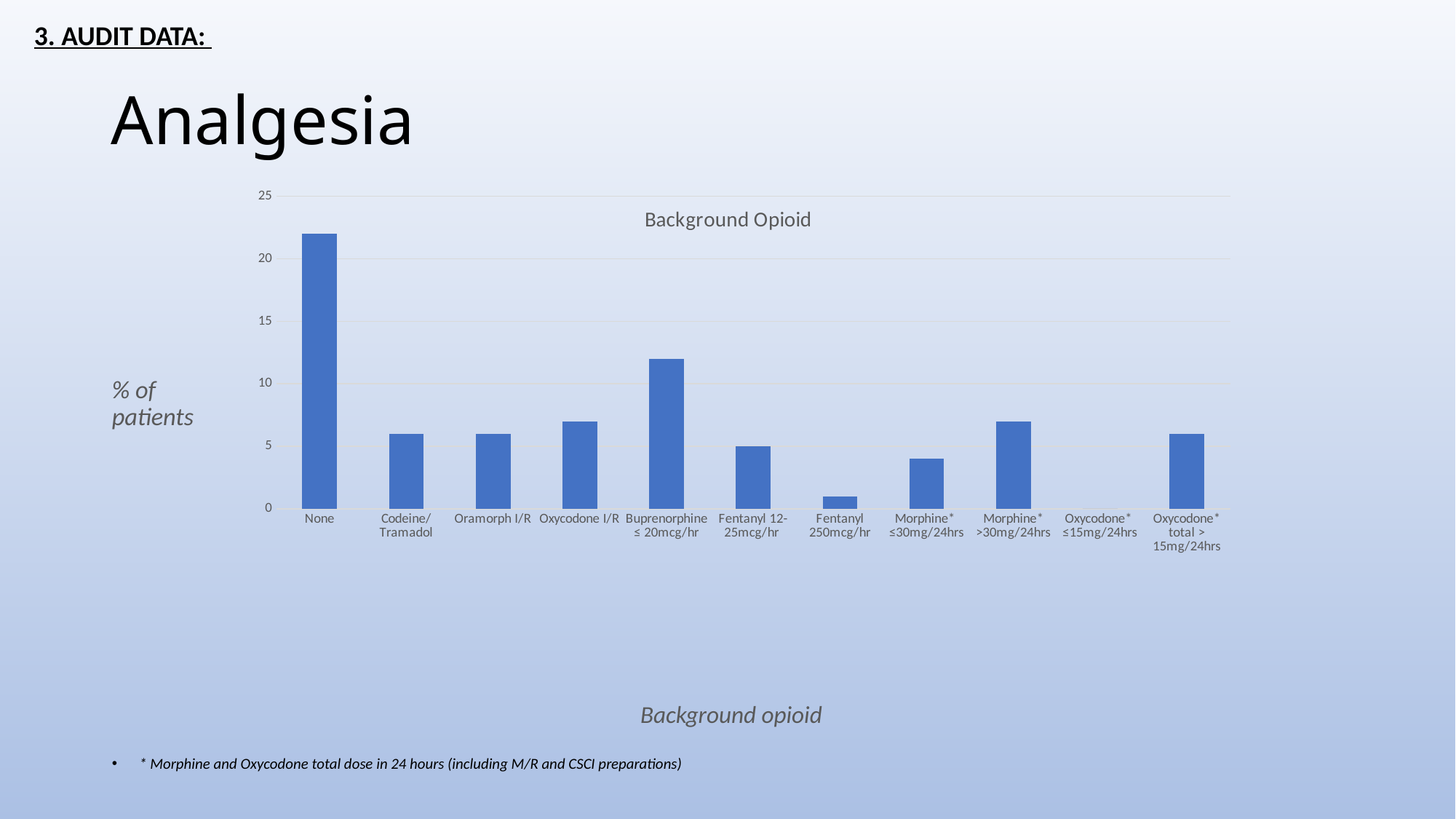
What is the title of the chart? Background Opioid How many background opioid categories are shown on the x axis? 11 What kind of chart is shown on the slide? bar chart Is the value for Fentanyl 250mcg/hr greater or less than 5? less Which background opioid category has the lowest percentage of patients? Oxycodone* ≤15mg/24hrs Which background opioid category has the highest percentage of patients? None Is the value for Buprenorphine ≤ 20mcg/hr greater or less than 10? greater Which has a higher percentage of patients, Morphine* ≤30mg/24hrs or Fentanyl 250mcg/hr? Morphine* ≤30mg/24hrs Which has a higher percentage of patients, Buprenorphine ≤ 20mcg/hr or Oxycodone I/R? Buprenorphine ≤ 20mcg/hr Is the value for None greater or less than 20? greater What does the vertical axis of the chart represent? % of patients